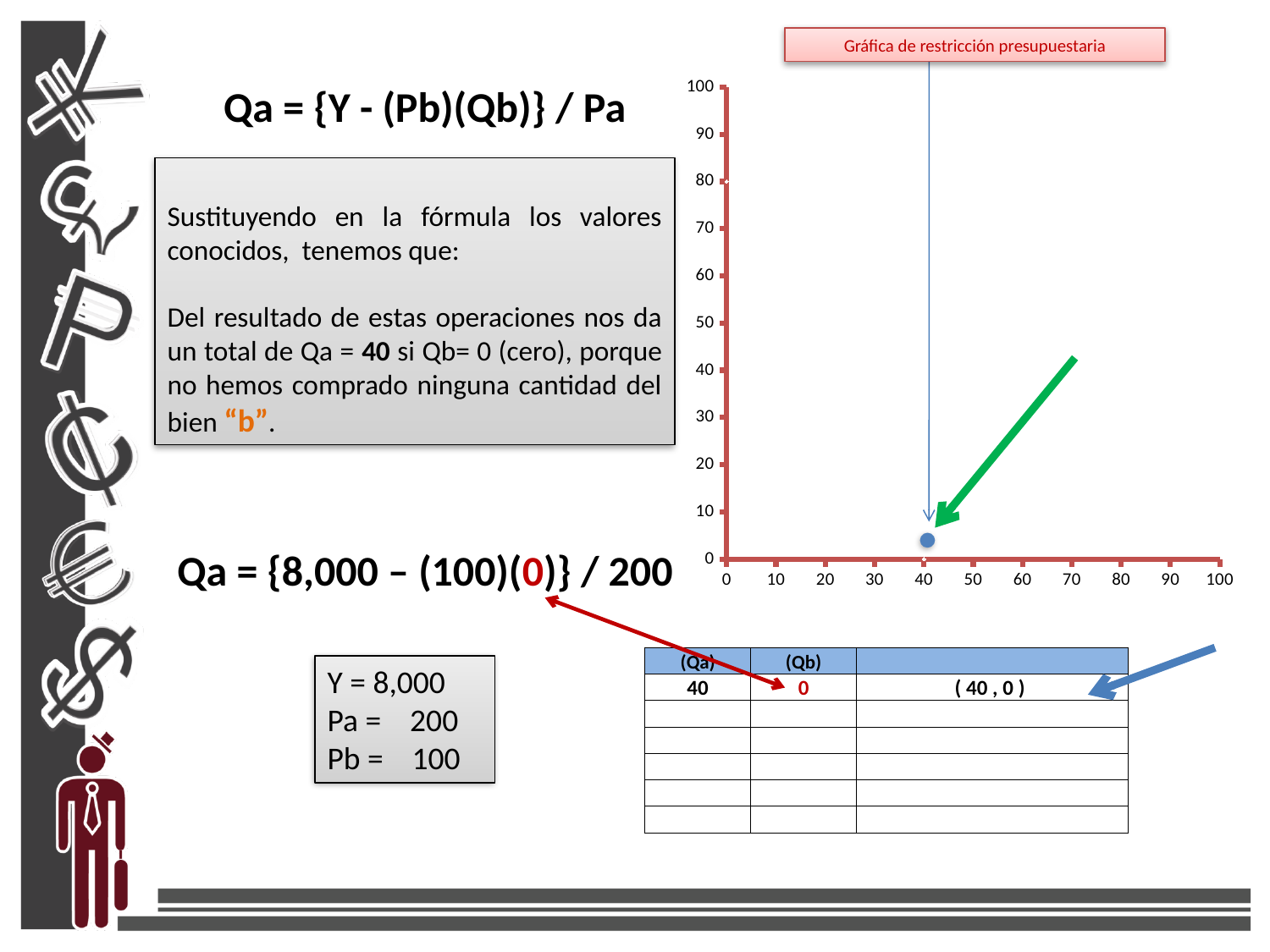
What are the coordinates of the plotted point, as given in the table below the chart? ( 40 , 0 ) What is the maximum value shown on the vertical axis of the chart? 100 What is the title of the chart? Gráfica de restricción presupuestaria What is the x-axis (Qa) value of the plotted point? 40 What kind of chart is shown on the slide? scatter chart What is the y-axis (Qb) value of the plotted point? 0 Is the x-axis value of the plotted point greater or less than 50? less Is the x-axis value of the plotted point greater or less than 30? greater How many data points are plotted on the chart? 1